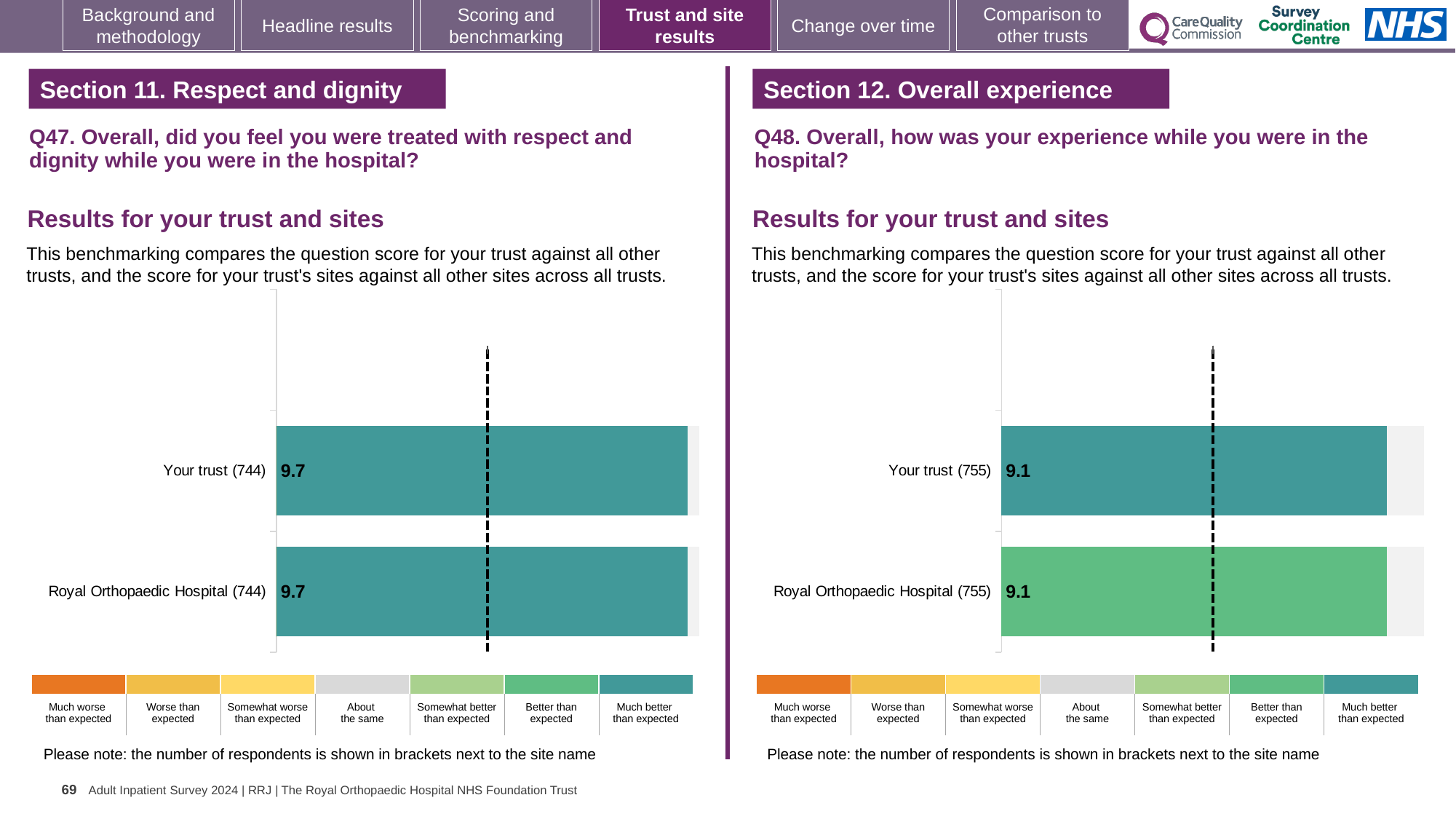
In the Q48 chart on the right, how many respondents are shown in brackets for Royal Orthopaedic Hospital? 755 In the Q48 chart on the right, what is the difference between the score for Your trust and the score for Royal Orthopaedic Hospital? 0.0 How many bars are plotted in the Q47 chart on the left? 2 In the Q48 chart on the right, what is the score for Your trust? 9.1 In the Q47 chart on the left, what is the score for Royal Orthopaedic Hospital? 9.7 In the Q47 chart on the left, what is the score for Your trust? 9.7 In the Q48 chart on the right, what is the score for Royal Orthopaedic Hospital? 9.1 How many bars are plotted in the Q48 chart on the right? 2 What type of chart is used for the Q47 results on the left? Bar chart In the Q47 chart on the left, what is the difference between the score for Your trust and the score for Royal Orthopaedic Hospital? 0.0 In the Q47 chart on the left, how many respondents are shown in brackets for Your trust? 744